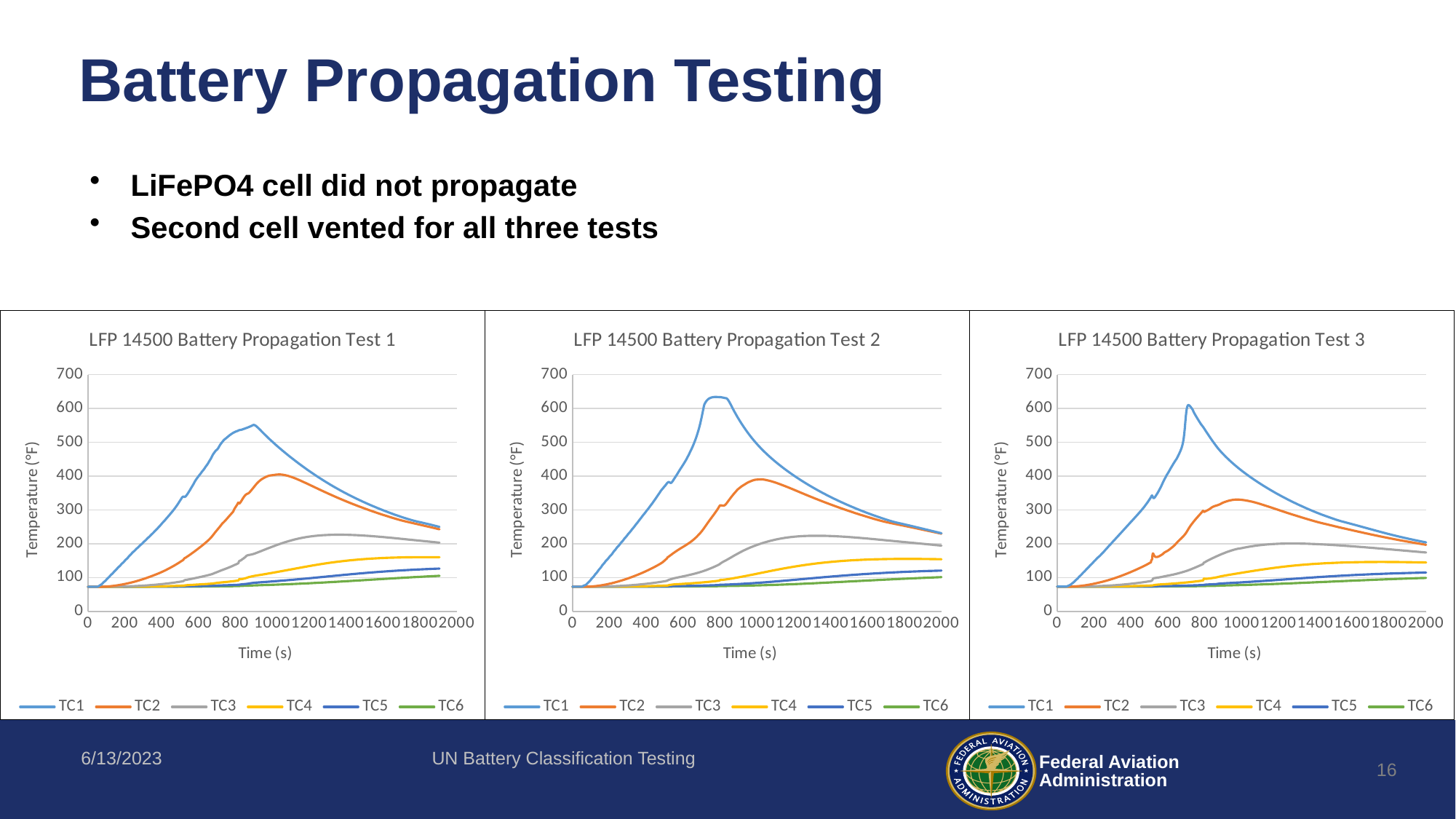
In the LFP 14500 Battery Propagation Test 1 chart, is the peak value of TC1 greater or less than 500? greater How many series does the legend of the LFP 14500 Battery Propagation Test 2 chart list? 6 Which chart shows a higher peak for TC1: LFP 14500 Battery Propagation Test 1 or Test 2? Test 2 In the LFP 14500 Battery Propagation Test 1 chart, which series reaches the highest temperature? TC1 In the LFP 14500 Battery Propagation Test 3 chart, which series stays lowest throughout the test? TC6 In the LFP 14500 Battery Propagation Test 2 chart, does TC1 rise or fall between 1000 s and 2000 s? fall What is the y-axis label on the LFP 14500 Battery Propagation Test 3 chart? Temperature (°F) Which chart shows a higher peak for TC2: LFP 14500 Battery Propagation Test 1 or Test 3? Test 1 In the LFP 14500 Battery Propagation Test 1 chart, is the peak value of TC3 greater or less than 300? less In the LFP 14500 Battery Propagation Test 2 chart, is the peak value of TC1 greater or less than 600? greater What kind of chart is the LFP 14500 Battery Propagation Test 1 chart? line chart